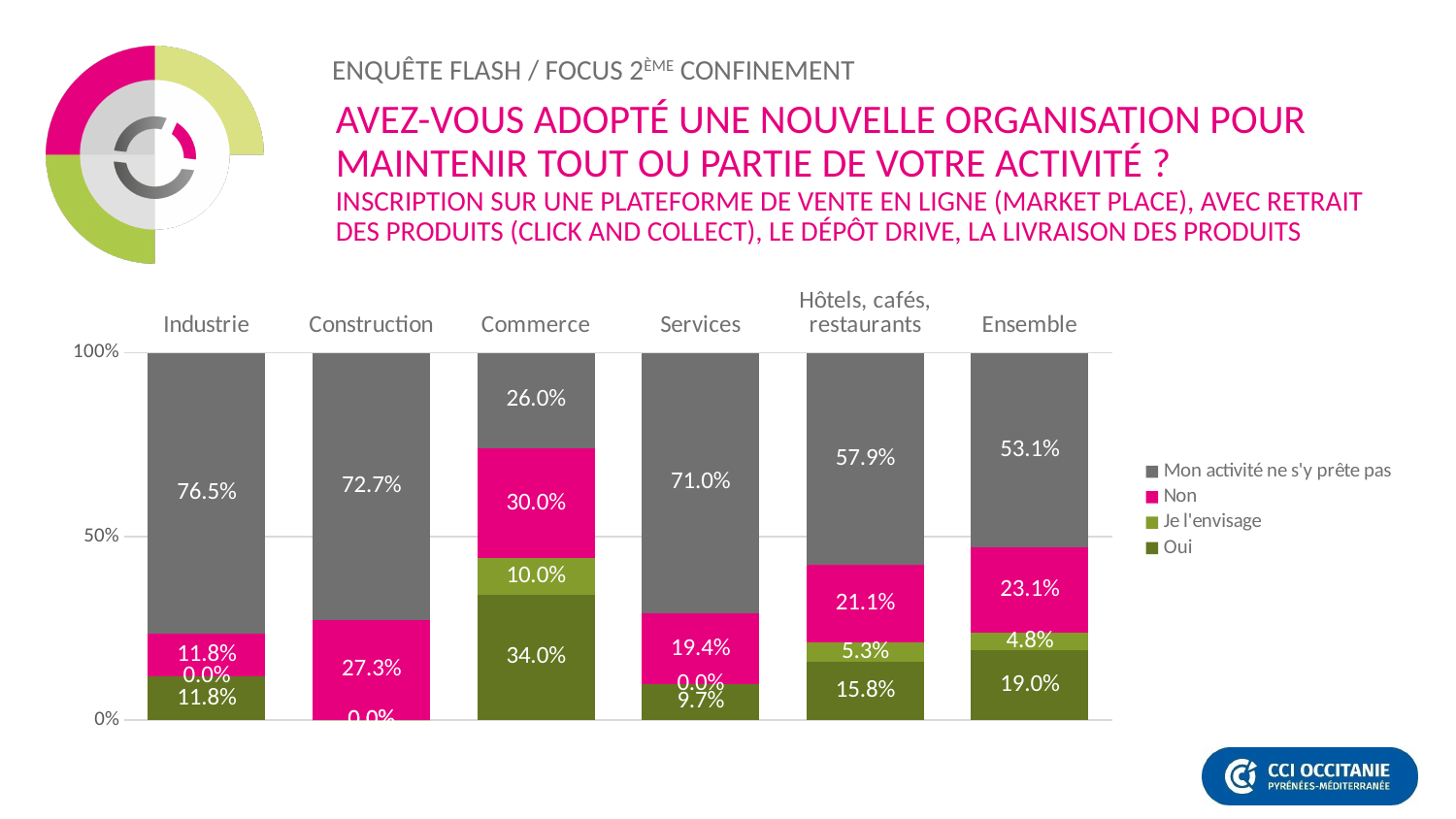
What is the value of "Oui" for Commerce? 34.0% What is the difference between the "Non" values for Commerce and Services? 10.6% What is the value of "Je l'envisage" for Ensemble? 4.8% Which is larger: the "Oui" value for Hôtels, cafés, restaurants or the "Oui" value for Services? Hôtels, cafés, restaurants Which series is shown in pink in the legend? Non What is the value of "Non" for Hôtels, cafés, restaurants? 21.1% What is the value of "Mon activité ne s'y prête pas" for Industrie? 76.5% How many categories are shown along the x axis? 6 How many series does the legend list? 4 Which category has the lowest value for "Mon activité ne s'y prête pas"? Commerce Which category has the highest value for "Oui"? Commerce What type of chart is shown on the slide? Stacked bar chart